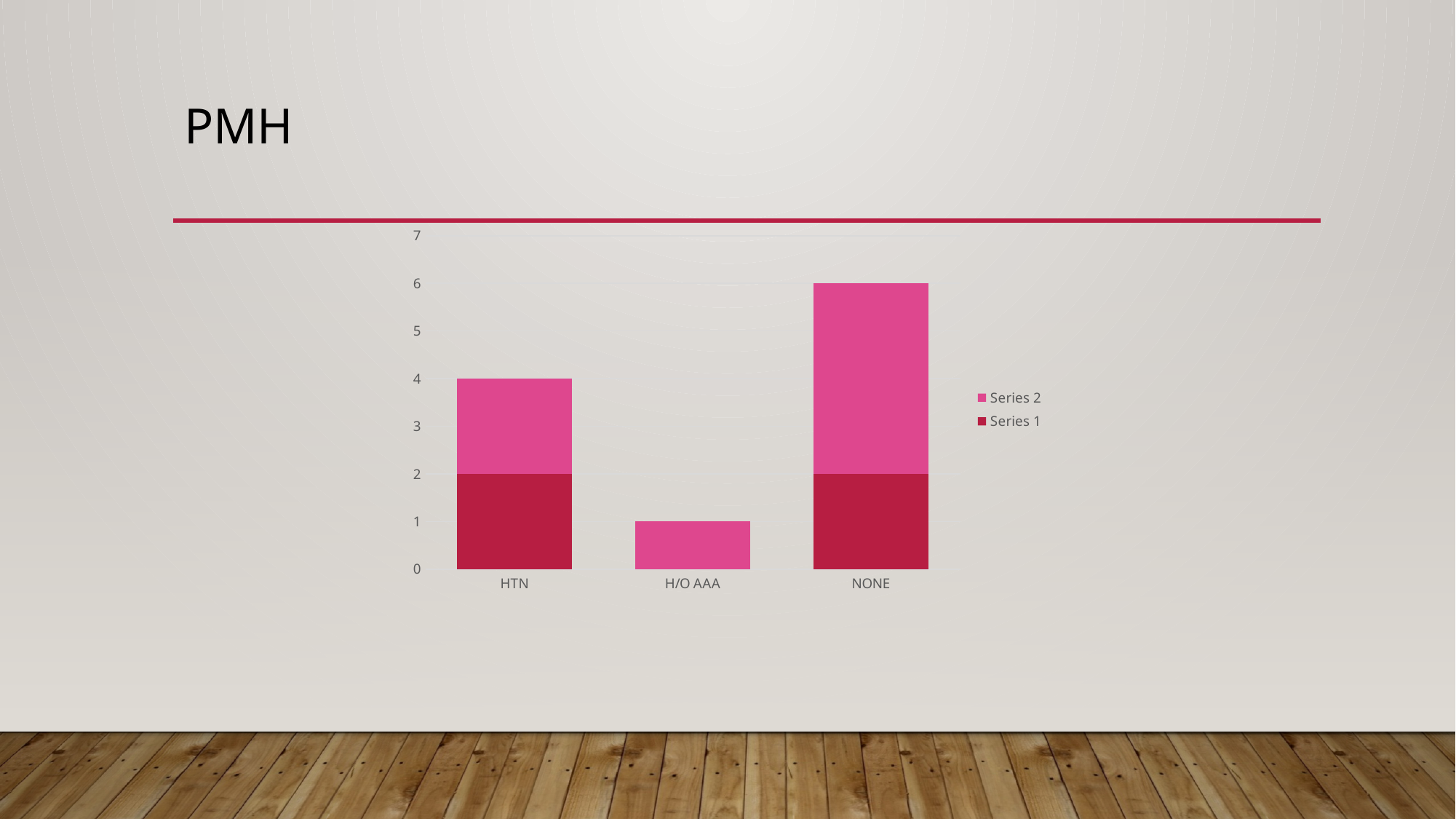
How many categories are shown on the x axis? 3 What is the total height of the stacked bar for H/O AAA? 1 What is the title of the slide containing the chart? PMH What is the difference between the total for NONE and the total for HTN? 2 Which category has the tallest stacked bar? NONE What is the total height of the stacked bar for HTN? 4 Which category has the shortest stacked bar? H/O AAA What kind of chart is shown on the slide? Stacked bar chart What is the total height of the stacked bar for NONE? 6 How many series does the legend list? 2 What is the value of Series 1 for NONE? 2 What is the value of Series 1 for HTN? 2